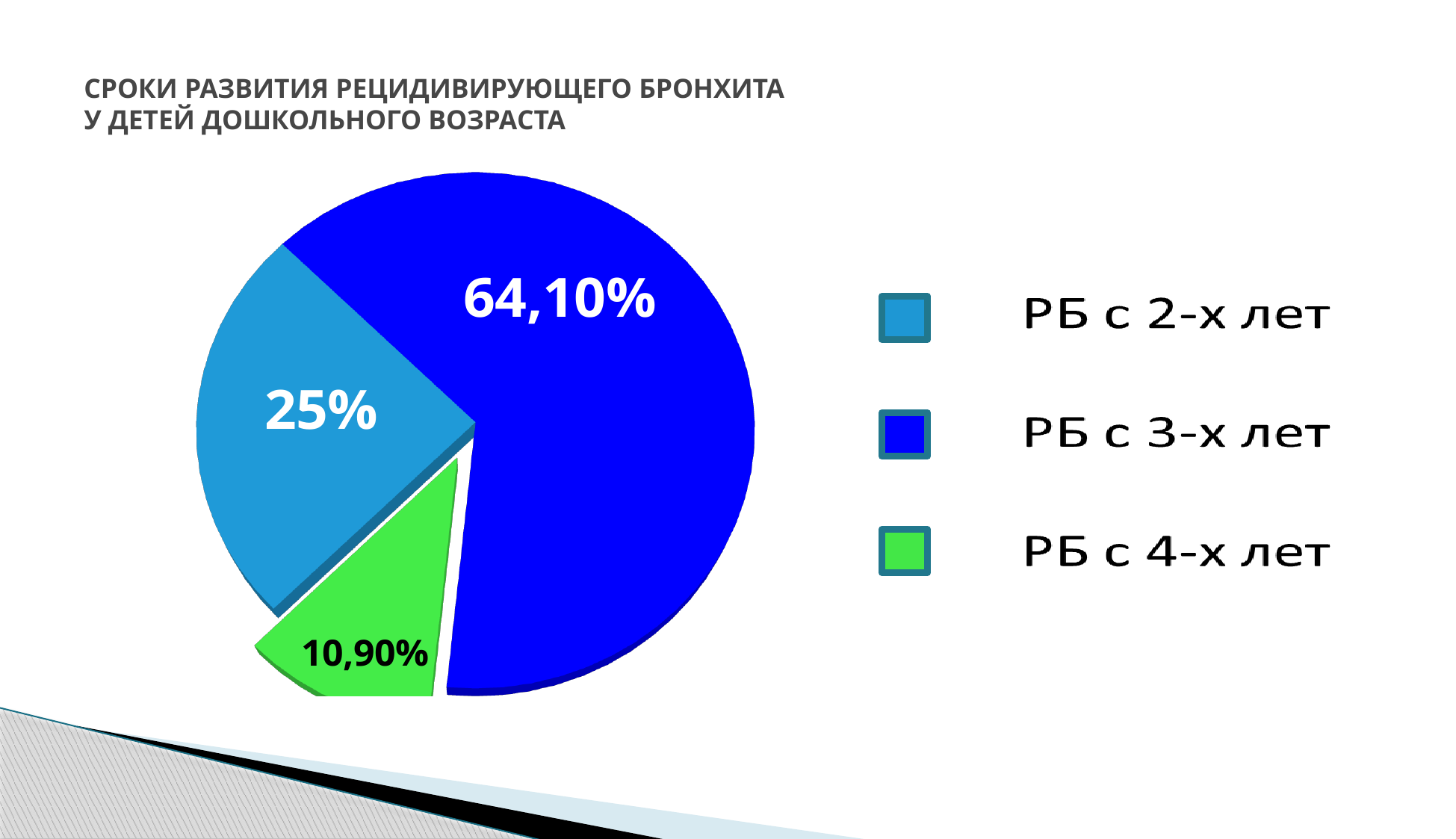
Which category has the largest slice of the pie? РБ с 3-х лет How many slices does the pie chart have? 3 What share of the pie is labelled for РБ с 2-х лет? 25% Which is larger: the slice for РБ с 2-х лет or the slice for РБ с 4-х лет? РБ с 2-х лет How many entries does the legend list? 3 What share of the pie is labelled for РБ с 3-х лет? 64,10% What is the title of the chart? СРОКИ РАЗВИТИЯ РЕЦИДИВИРУЮЩЕГО БРОНХИТА У ДЕТЕЙ ДОШКОЛЬНОГО ВОЗРАСТА What share of the pie is labelled for РБ с 4-х лет? 10,90% What kind of chart is shown on the slide? pie chart What is the difference in percentage points between the slices for РБ с 3-х лет and РБ с 2-х лет? 39,10% What colour is the slice for РБ с 4-х лет? green Which category has the smallest slice of the pie? РБ с 4-х лет